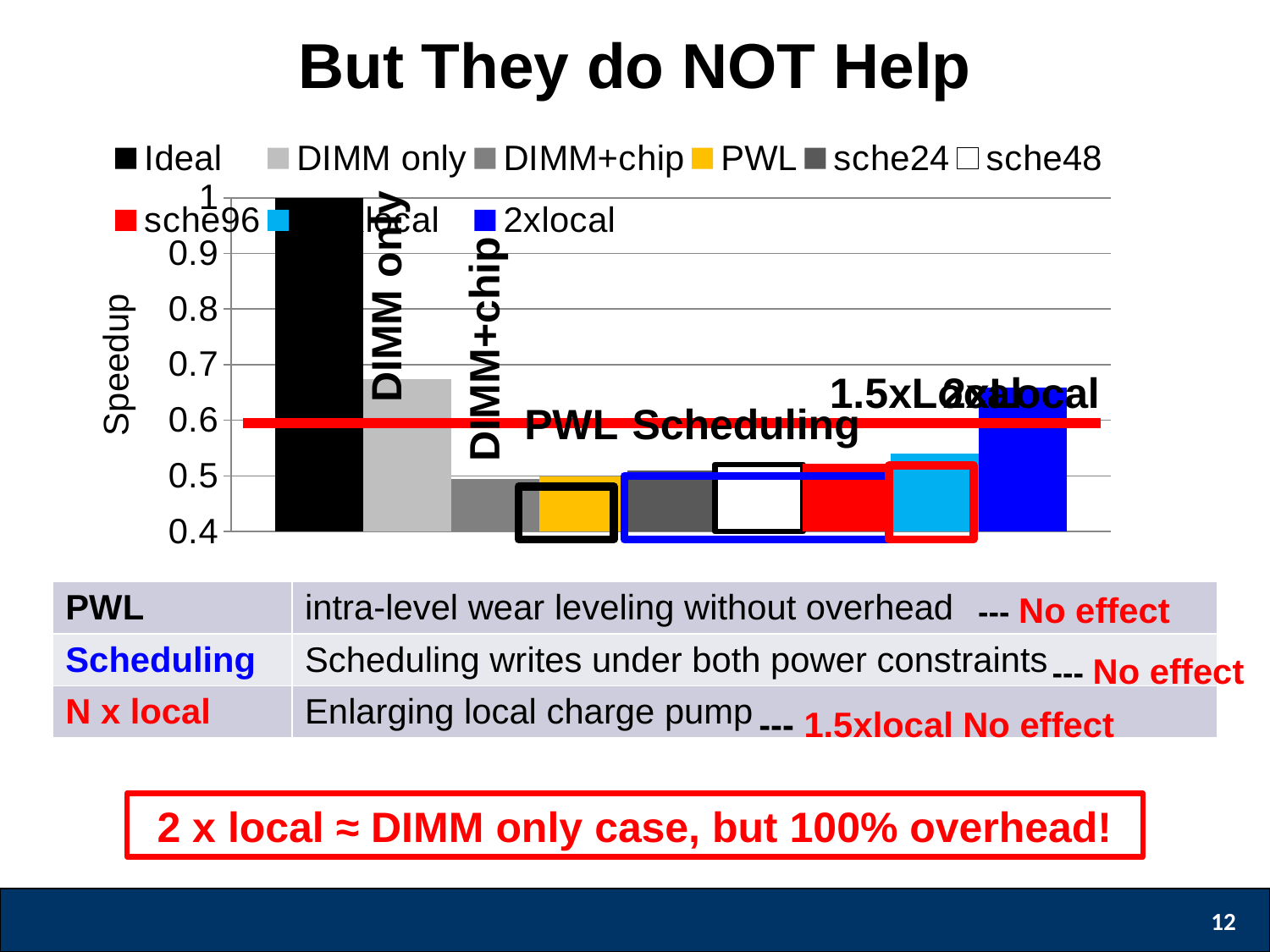
Is the speedup for sche96 greater or less than 0.6? less What is the label of the vertical axis of the chart? Speedup How many series does the chart legend list? 9 What colour represents the PWL series in the chart legend? yellow Is the speedup for 2xlocal greater or less than 0.6? greater What is the speedup value for the Ideal series? 1 Is the speedup for PWL greater or less than 0.6? less Which has a higher speedup, 2xlocal or PWL? 2xlocal What kind of chart is shown on the slide? bar chart Which has a higher speedup, Ideal or DIMM only? Ideal Which series has the highest speedup in the chart? Ideal